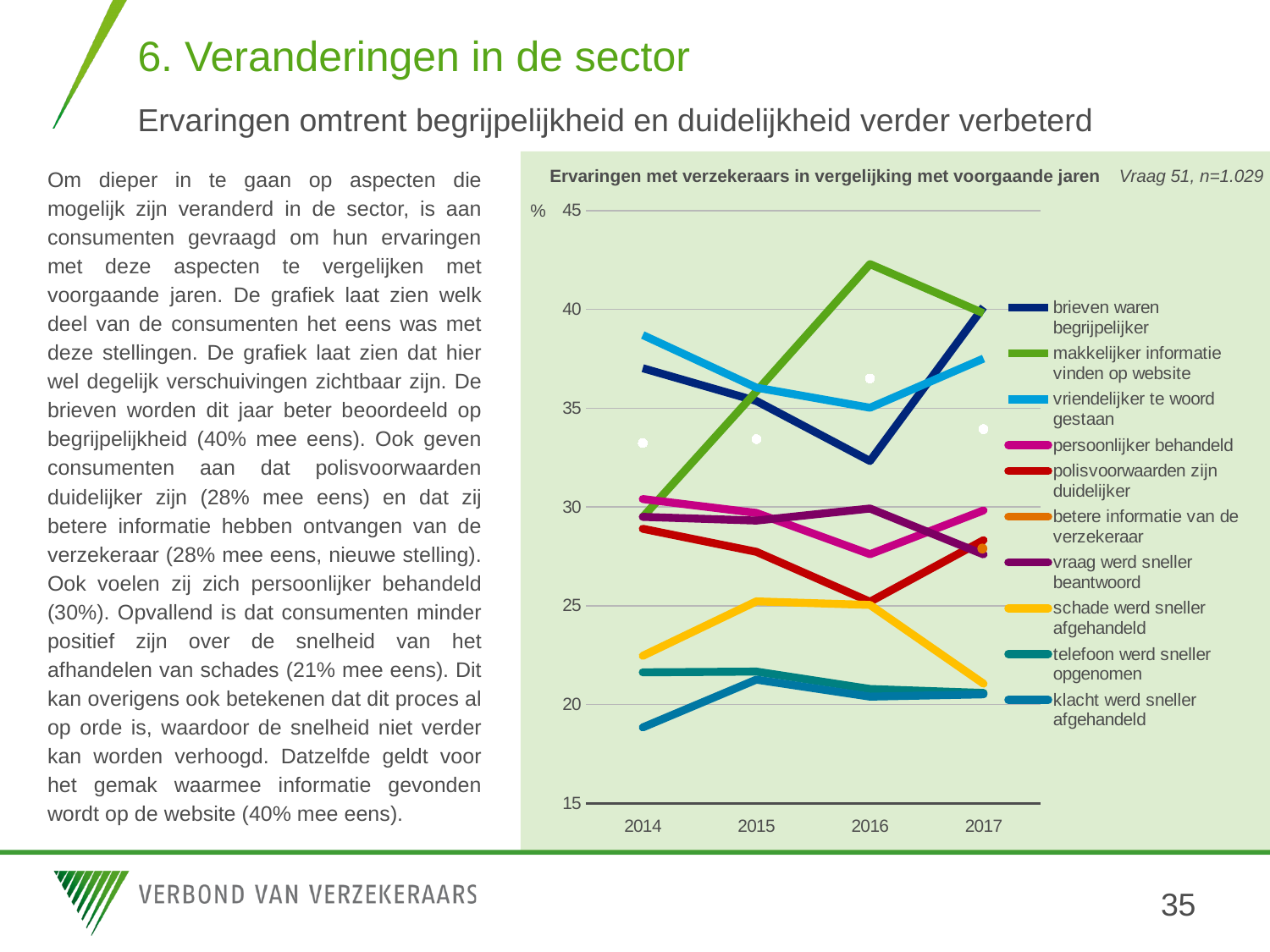
What is the title of the chart? Ervaringen met verzekeraars in vergelijking met voorgaande jaren What kind of chart is shown on the slide? line chart Is the value for 'klacht werd sneller afgehandeld' in 2014 greater or less than 20? less Is the value for 'brieven waren begrijpelijker' in 2016 greater or less than 35? less Does the line for 'makkelijker informatie vinden op website' rise or fall from 2014 to 2016? rise Is the value for 'makkelijker informatie vinden op website' in 2016 greater or less than 40? greater How many series does the chart legend list? 10 Does the line for 'schade werd sneller afgehandeld' rise or fall from 2016 to 2017? fall In 2016, which is higher: 'makkelijker informatie vinden op website' or 'brieven waren begrijpelijker'? makkelijker informatie vinden op website Which series has the lowest value in 2014? klacht werd sneller afgehandeld How many years are shown on the x axis of the chart? 4